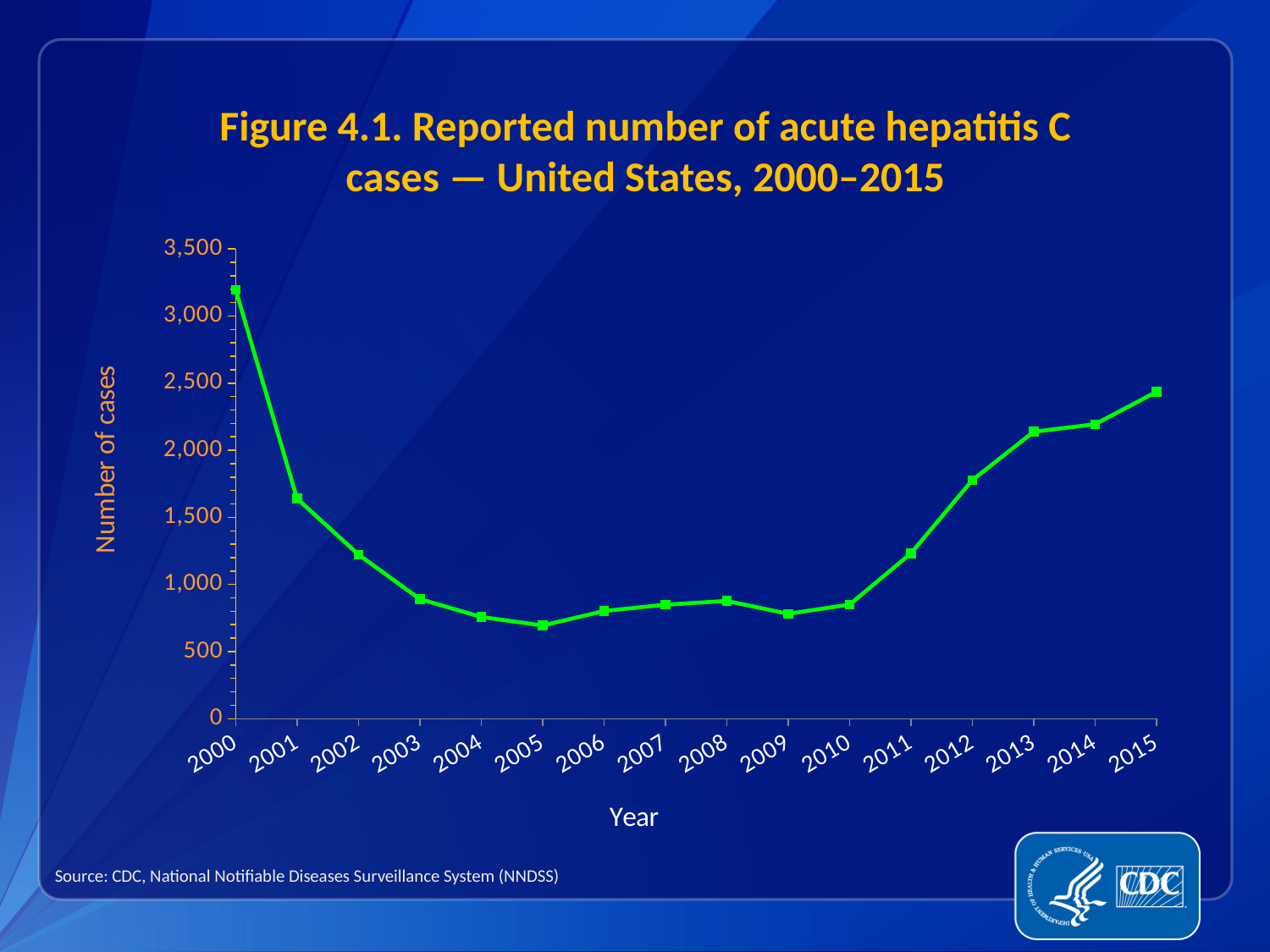
How many years are plotted on the x axis? 16 Do the reported cases rise or fall from 2010 to 2015? rise Which year has the highest reported number of acute hepatitis C cases? 2000 Which year has the lowest reported number of acute hepatitis C cases? 2005 Is the value for 2000 greater or less than 3,000? greater Is the value for 2012 greater or less than 1,500? greater Is the value for 2005 greater or less than 1,000? less What is the label of the vertical axis? Number of cases What kind of chart is shown on the slide? line chart Which year has more reported cases, 2000 or 2015? 2000 Do the reported cases rise or fall from 2000 to 2005? fall